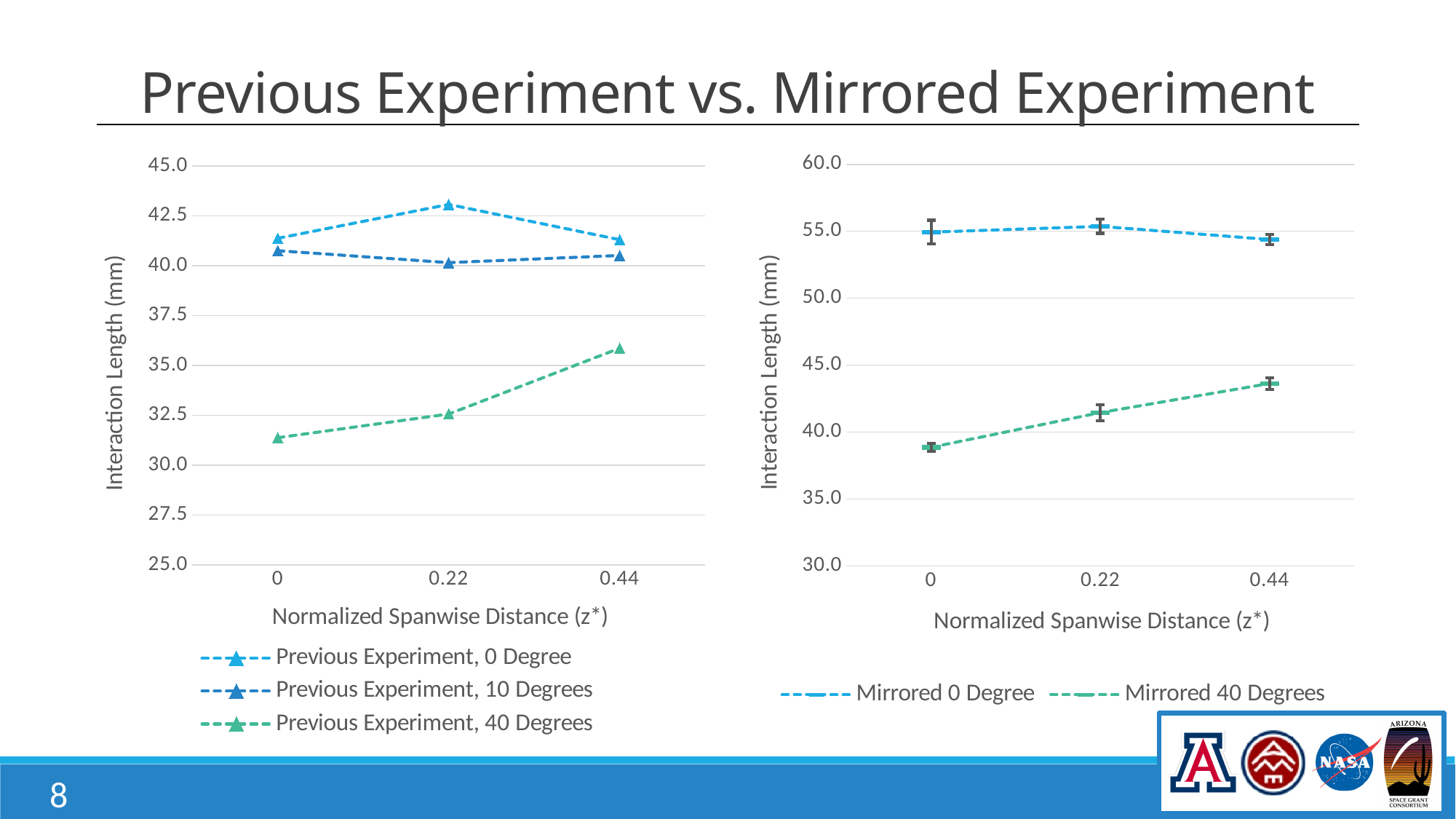
In the left chart, which series has the highest value at z* = 0.22? Previous Experiment, 0 Degree How many x-axis points are plotted for each series in the right chart? 3 How many series does the legend of the left chart list? 3 In the left chart, does the Previous Experiment, 40 Degrees series rise or fall as the normalized spanwise distance increases from 0 to 0.44? rise In the left chart, which series has the lowest value at z* = 0? Previous Experiment, 40 Degrees What type of chart is the left chart on the slide? line chart In the right chart, is the value for Mirrored 40 Degrees at z* = 0 greater or less than 40.0? less In the left chart, is the value for Previous Experiment, 40 Degrees at z* = 0.44 greater or less than 35.0? greater How many series does the legend of the right chart list? 2 In the right chart, does the Mirrored 40 Degrees series rise or fall from z* = 0 to z* = 0.44? rise In the right chart, is the value for Mirrored 0 Degree at z* = 0.44 greater or less than 50.0? greater What is the y-axis title of the right chart? Interaction Length (mm)